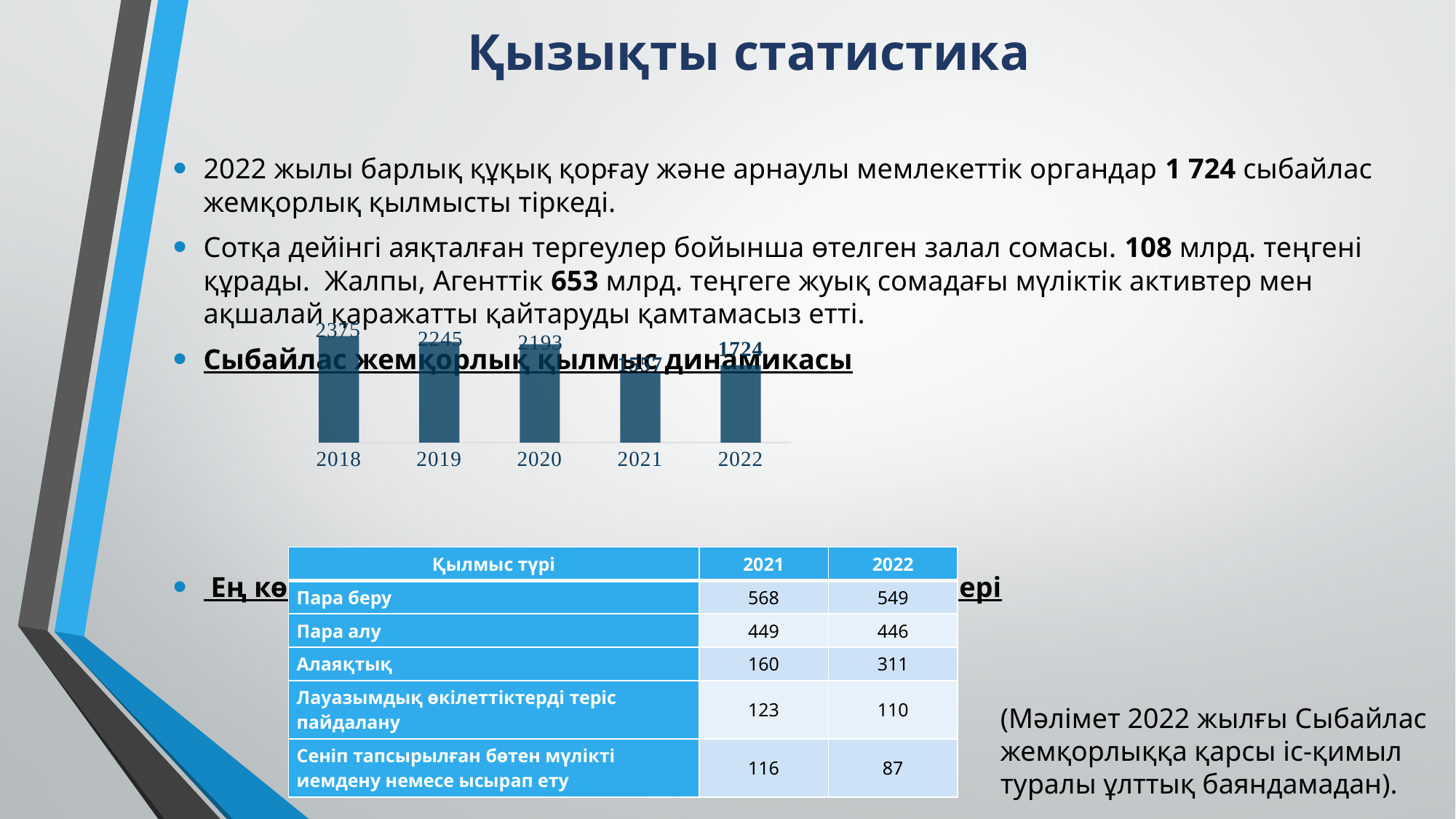
What is the difference between the values for 2018 and 2022 in the bar chart? 651 What kind of chart is shown on the slide? bar chart Which is larger in the bar chart, the value for 2019 or the value for 2022? 2019 What is the value for 2022 in the bar chart? 1724 Which year has the lowest value in the bar chart? 2021 Which year has the highest value in the bar chart? 2018 What is the value for 2019 in the bar chart? 2245 What is the value for 2018 in the bar chart? 2375 What is the difference between the values for 2018 and 2019 in the bar chart? 130 How many years are shown on the x axis of the bar chart? 5 Do the values in the bar chart rise or fall from 2018 to 2021? fall What is the value for 2020 in the bar chart? 2193